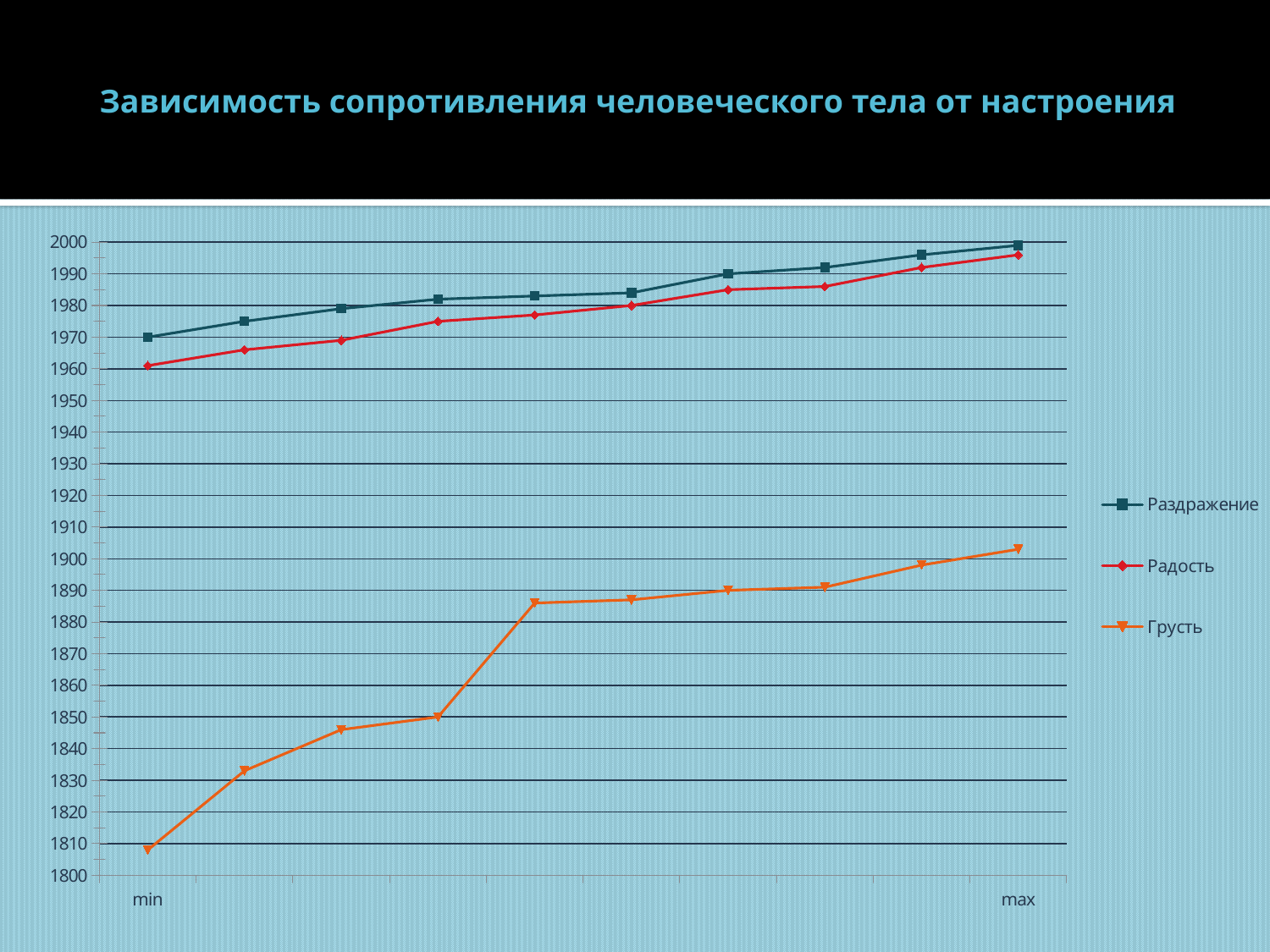
Does the Грусть series rise or fall from min to max along the x axis? rises At min, which series has the larger value, Раздражение or Радость? Раздражение What kind of chart is shown on the slide? line chart How many data points does the Грусть series have? 10 Which series has the highest values across the chart? Раздражение What is the title of the chart? Зависимость сопротивления человеческого тела от настроения Is the value for Радость at min greater or less than 1970? less Is the value for Раздражение at max greater or less than 1990? greater Which series has the lowest values across the chart? Грусть How many series does the legend list? 3 Is the value for Грусть at min greater or less than 1820? less What colour is the line for the Грусть series? orange